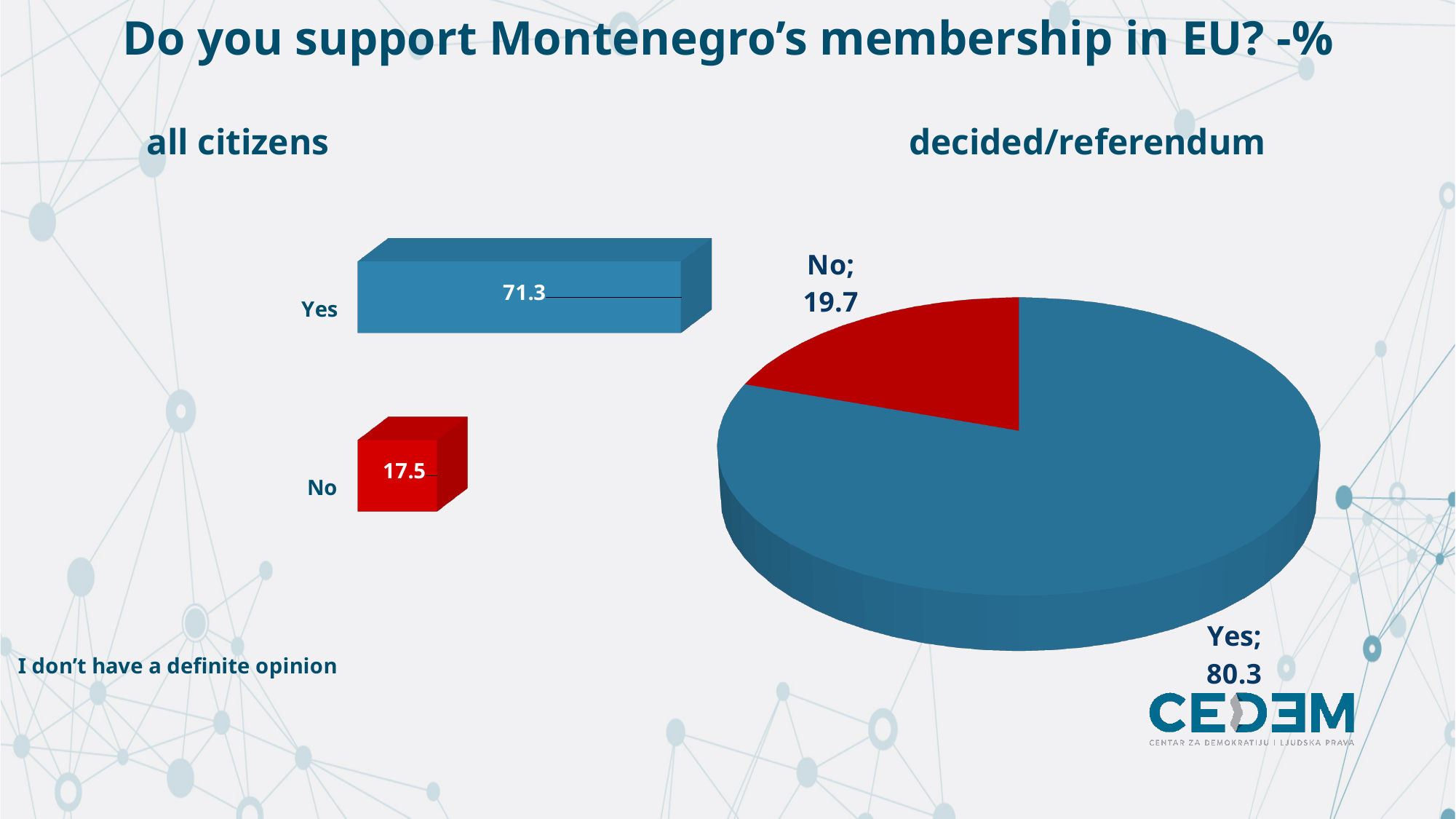
In the 'decided/referendum' chart, what is the difference between the Yes and No values? 60.6 In the 'all citizens' chart, what is the difference between the Yes and No values? 53.8 In the 'all citizens' chart, what is the value for No? 17.5 In the 'all citizens' chart, which category has the highest value? Yes In the 'all citizens' chart, what is the value for Yes? 71.3 In the 'decided/referendum' chart, which slice is the smallest? No How many slices does the 'decided/referendum' pie chart have? 2 In the 'decided/referendum' chart, which is larger, Yes or No? Yes What kind of chart is the 'decided/referendum' chart? Pie chart In the 'decided/referendum' chart, what is the value for Yes? 80.3 What kind of chart is the 'all citizens' chart? Bar chart In the 'decided/referendum' chart, what is the value for No? 19.7